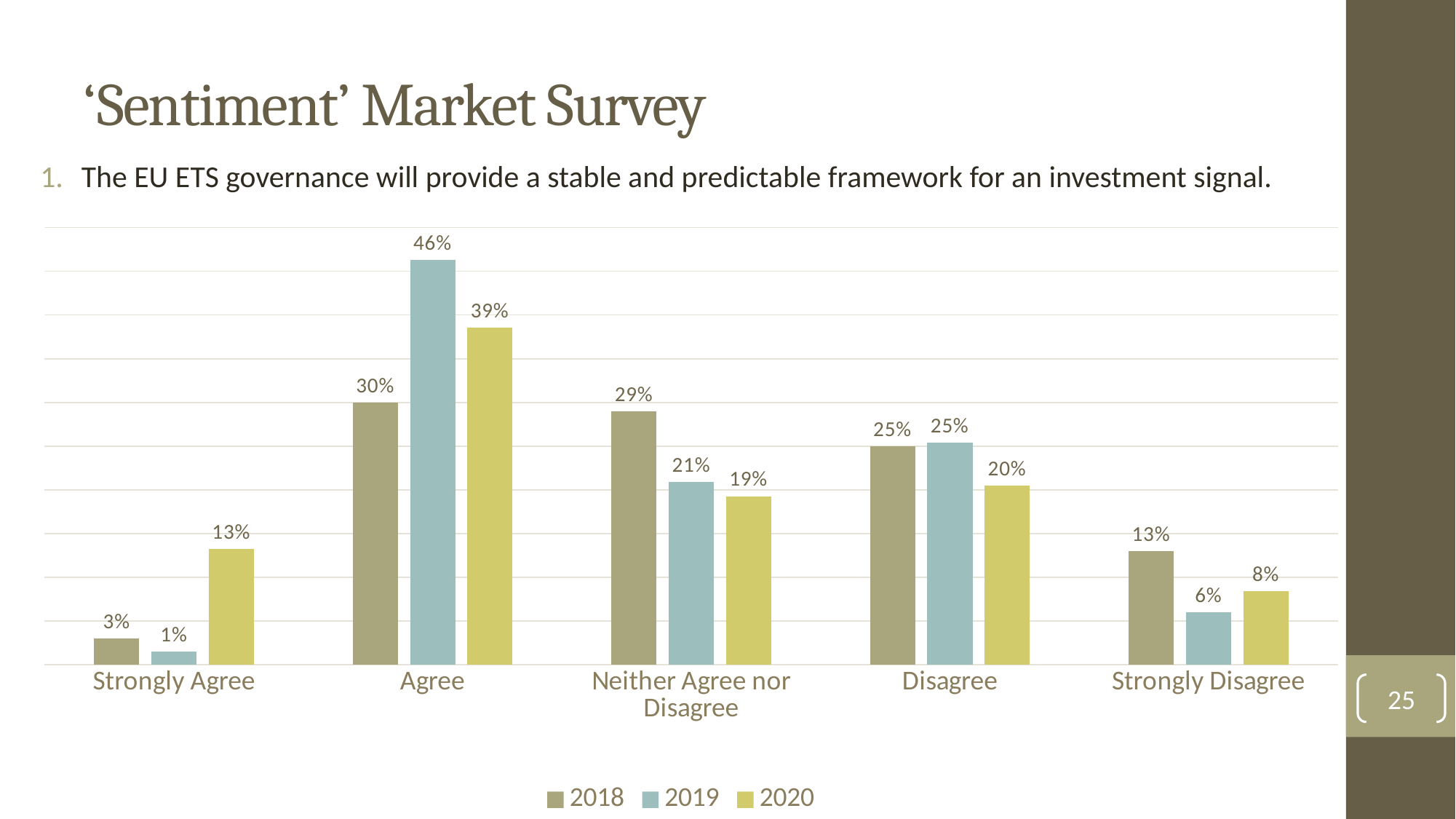
How many categories are shown on the x axis? 5 Which years are listed in the chart legend? 2018, 2019, 2020 What is the value for 2020 in the Strongly Agree category? 13% What is the value for 2018 in the Neither Agree nor Disagree category? 29% What is the difference between the 2019 and 2020 values in the Agree category? 7% What kind of chart is shown on the slide? Bar chart Which category has the lowest value for the 2019 series? Strongly Agree How many series does the legend list? 3 Which category has the highest value for the 2020 series? Agree Which is larger: the 2018 value for Strongly Disagree or the 2019 value for Strongly Disagree? 2018 What is the value for 2019 in the Agree category? 46%